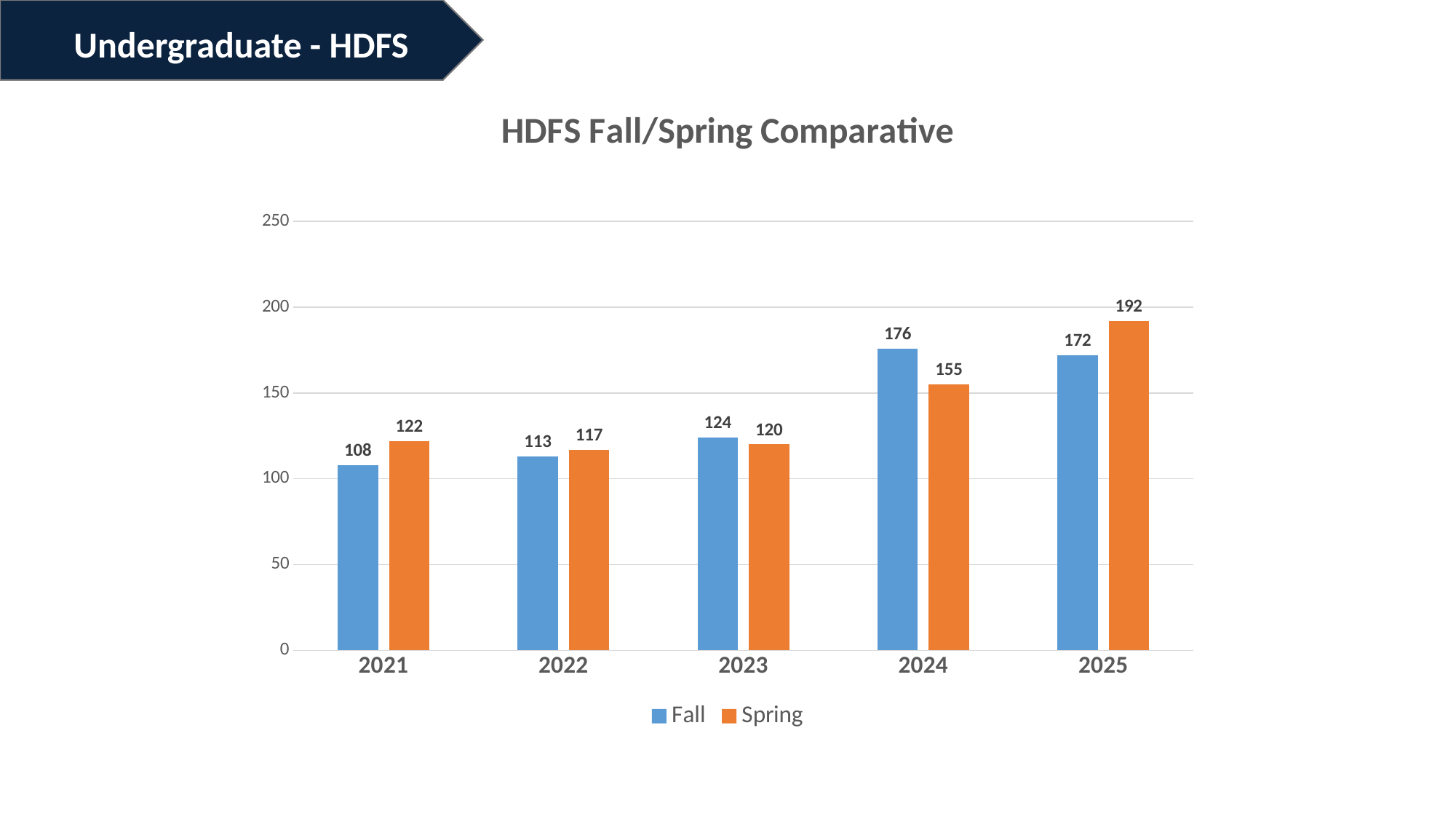
What kind of chart is shown? bar chart What is the title of the chart? HDFS Fall/Spring Comparative Do the Fall values rise or fall from 2021 to 2024? rise Which year has the highest Spring value? 2025 Which is larger in 2024, the Fall value or the Spring value? Fall What is the Fall value for 2024? 176 What is the difference between the Spring and Fall values in 2025? 20 How many years are shown on the x axis? 5 Which year has the lowest Fall value? 2021 What is the Spring value for 2021? 122 How many series does the legend list? 2 Is the Spring value for 2024 greater or less than 150? greater